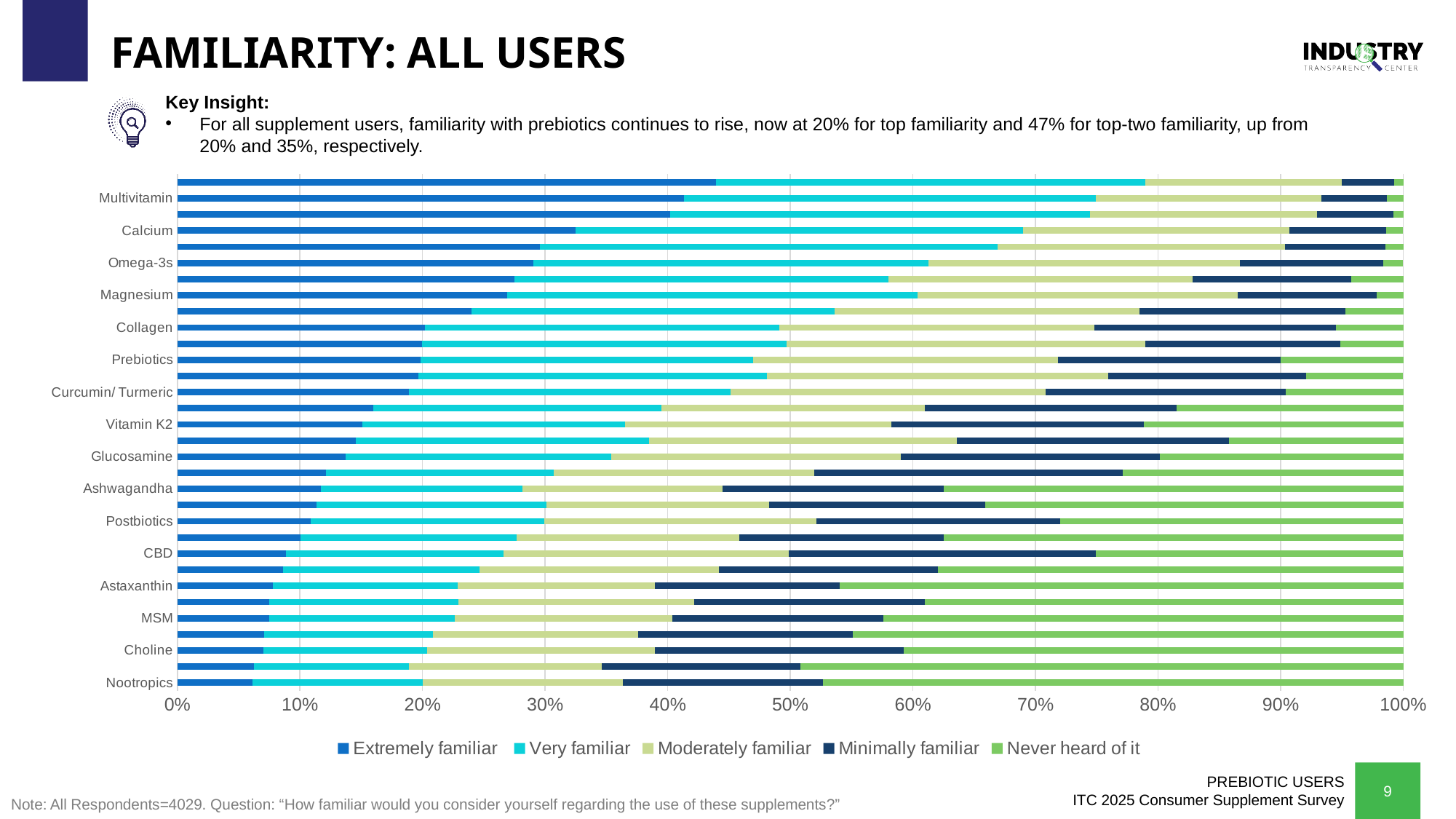
Which has a larger Never heard of it share, Nootropics or Choline? Nootropics Moving down the chart from Multivitamin to Nootropics, does the Extremely familiar share rise or fall? Fall Is the Extremely familiar value for Nootropics greater or less than 10%? less Is the Never heard of it value for Nootropics greater or less than 40%? greater Is the Never heard of it value for CBD greater or less than 20%? greater Which has a larger Extremely familiar share, Multivitamin or Nootropics? Multivitamin What is the title of the slide? FAMILIARITY: ALL USERS How many series does the legend list? 5 What kind of chart is shown on the slide? Stacked bar chart